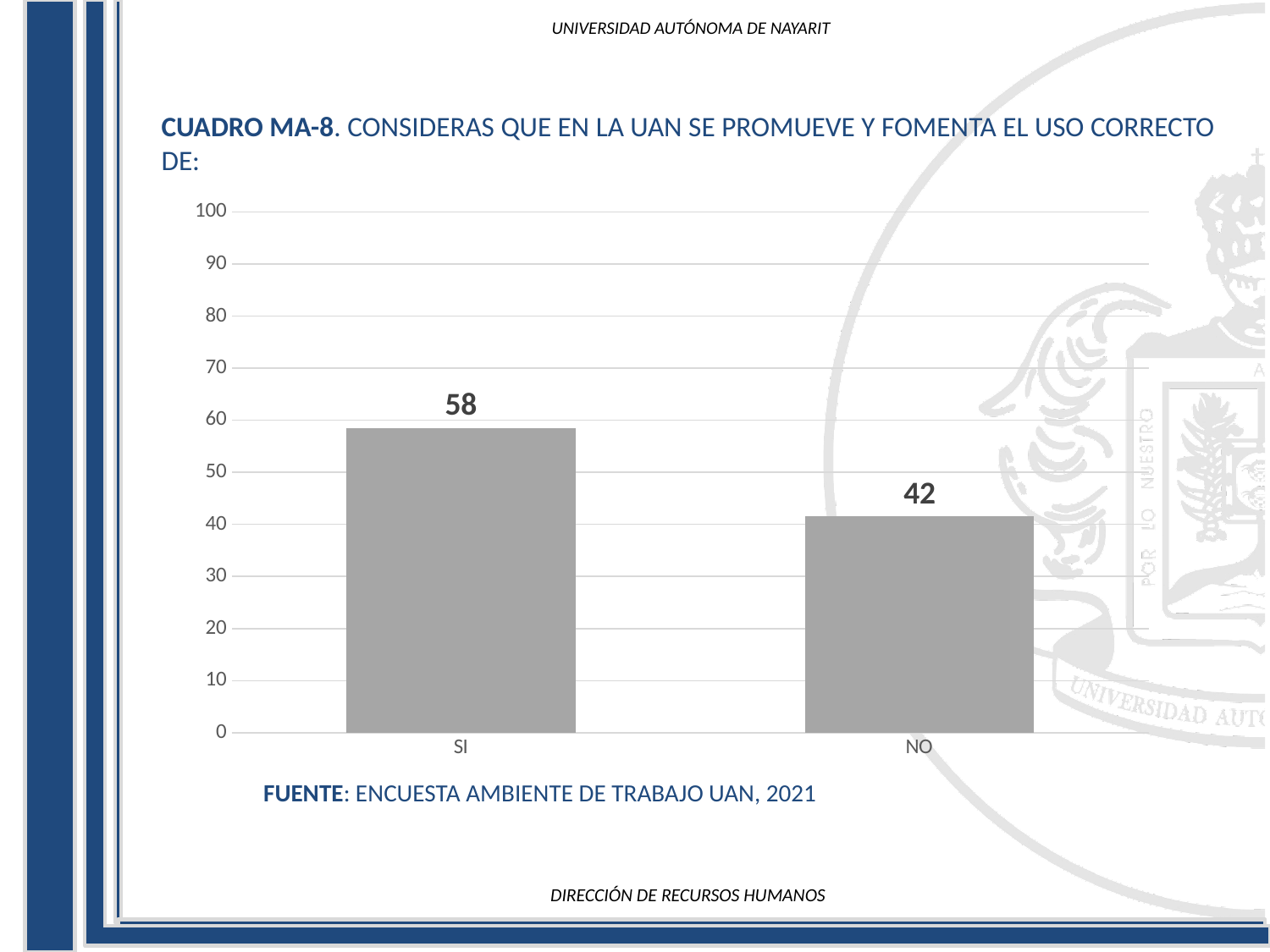
What is the difference between the values for SI and NO? 16 What is the value for SI? 58 What is the total of the two values shown in the chart? 100 What is the source cited below the chart? ENCUESTA AMBIENTE DE TRABAJO UAN, 2021 What kind of chart is shown on the slide? bar chart Which category has the highest value? SI Which category has the lowest value? NO Is the value for NO greater or less than 50? less Is the value for SI greater or less than 50? greater Which is larger, the value for SI or the value for NO? SI How many categories are shown on the x axis? 2 What is the value for NO? 42